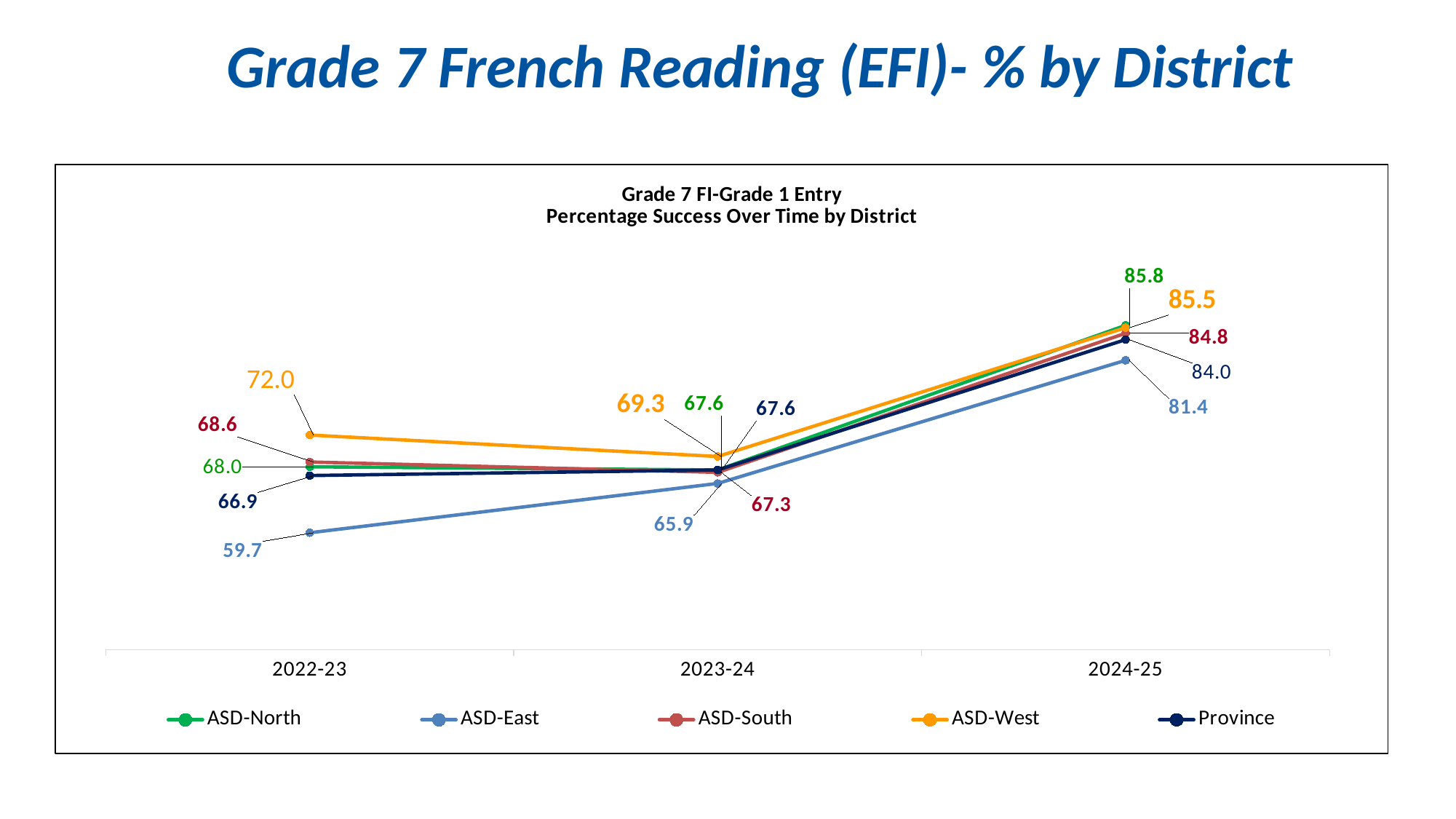
How many series does the legend list? 5 What kind of chart is shown on the slide? Line chart What is the value for ASD-West in 2022-23? 72.0 Does the ASD-East line rise or fall from 2022-23 to 2024-25? Rise What is the value for ASD-South in 2022-23? 68.6 What is the value for Province in 2023-24? 67.6 What is the value for ASD-East in 2024-25? 81.4 Which district has the lowest value in 2022-23? ASD-East Which is larger in 2024-25, ASD-South or Province? ASD-South Which series has the highest value in 2022-23? ASD-West What is the difference between ASD-North's 2024-25 value and its 2023-24 value? 18.2 What is the difference between ASD-West and ASD-East in 2022-23? 12.3